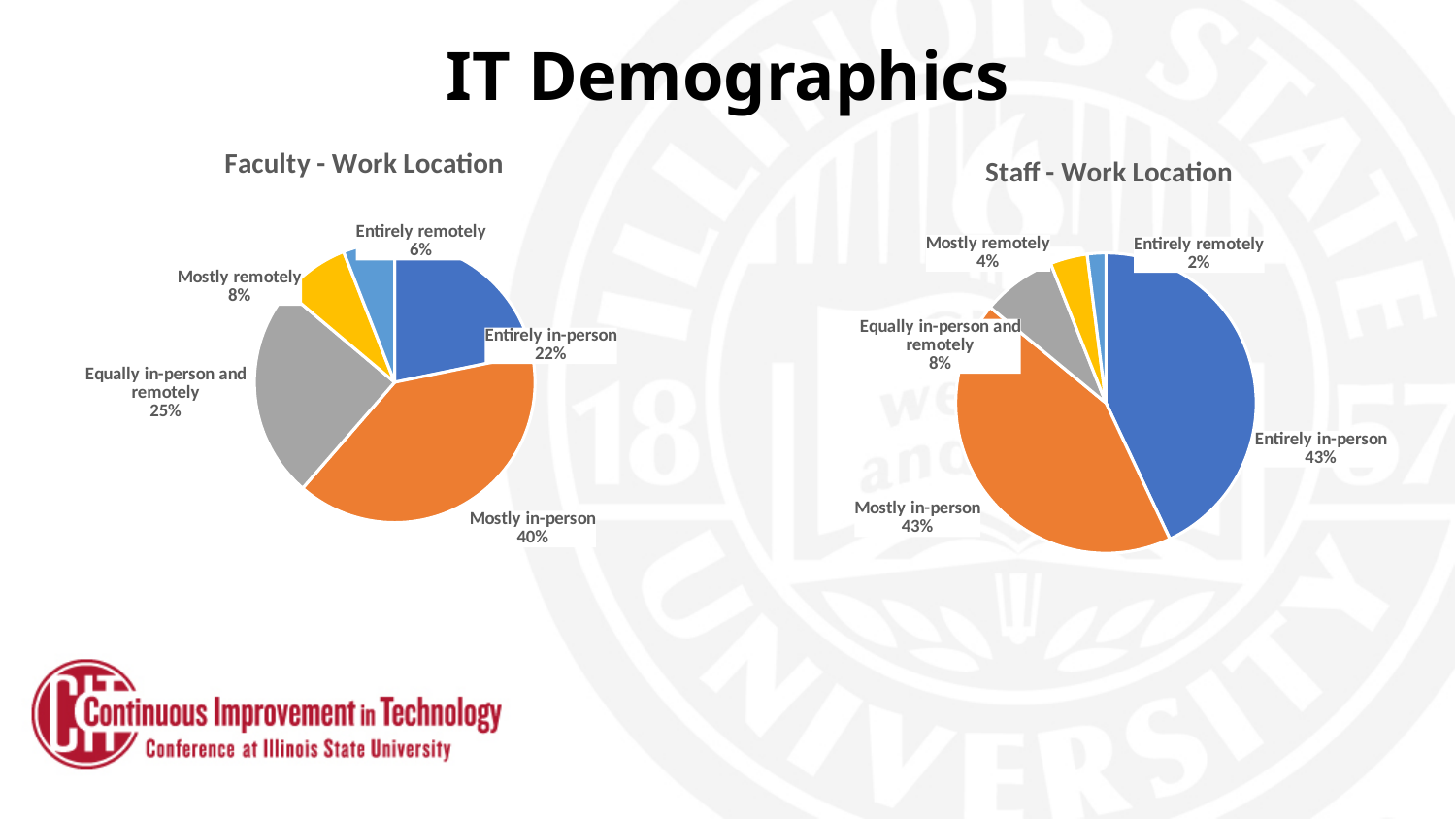
In the Staff - Work Location chart, what is the difference between the Equally in-person and remotely share and the Mostly remotely share? 4% How many categories are shown in the Staff - Work Location chart? 5 In the Faculty - Work Location chart, which work location category has the largest share? Mostly in-person In the Faculty - Work Location chart, which is larger: the share for Equally in-person and remotely or the share for Entirely in-person? Equally in-person and remotely In the Faculty - Work Location chart, which work location category has the smallest share? Entirely remotely In the Faculty - Work Location chart, what is the difference between the Mostly in-person share and the Entirely in-person share? 18% Which is larger: the Entirely in-person share in the Faculty - Work Location chart or the Entirely in-person share in the Staff - Work Location chart? Staff - Work Location In the Faculty - Work Location chart, what percentage of faculty work mostly in-person? 40% In the Staff - Work Location chart, what percentage of staff work equally in-person and remotely? 8% What is the title of the chart on the right side of the slide? Staff - Work Location What type of chart is the Faculty - Work Location chart? Pie chart In the Staff - Work Location chart, which work location category has the smallest share? Entirely remotely